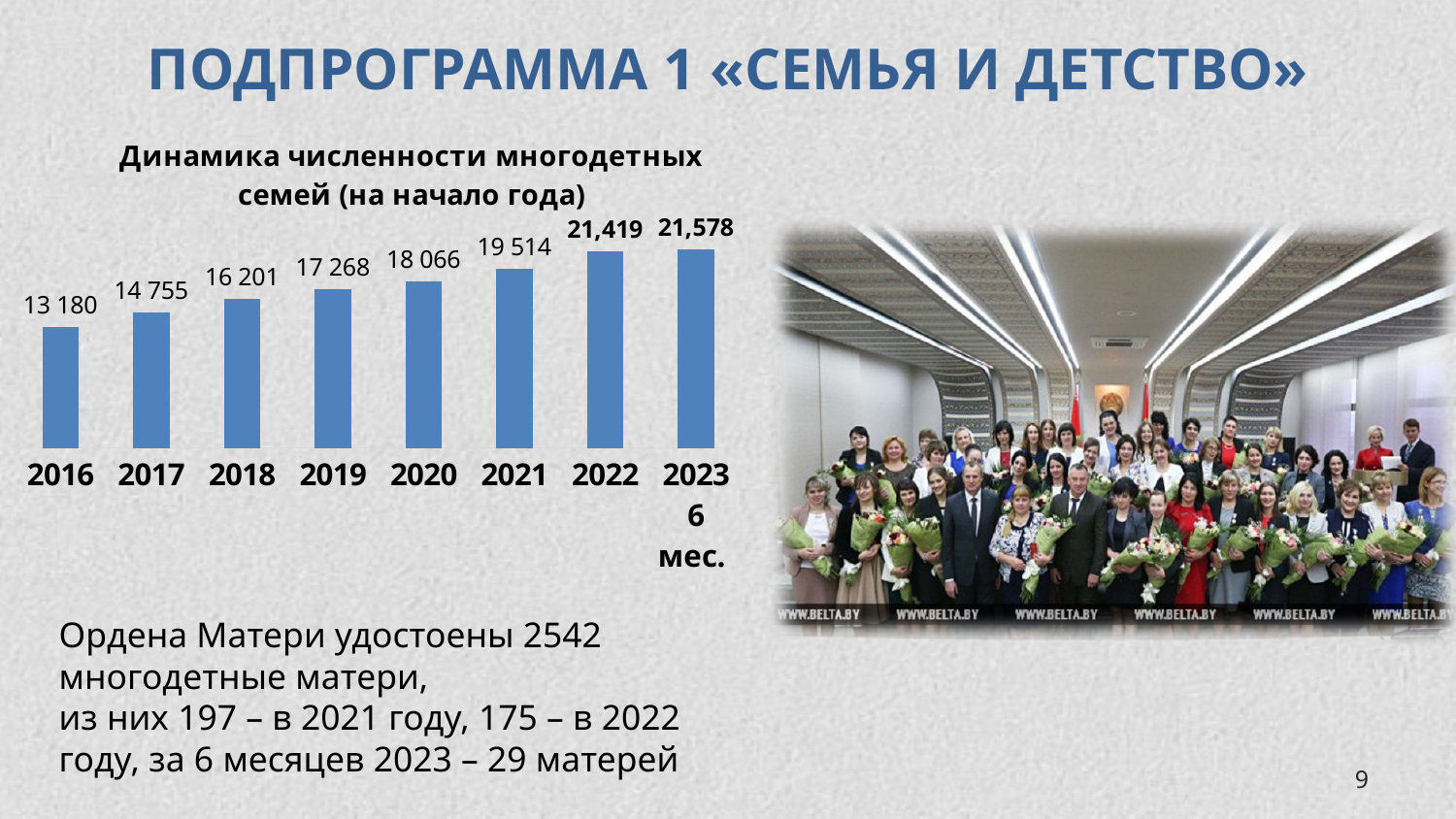
What is the value shown for 2022 in the chart? 21,419 What is the value for 2020 in the chart? 18 066 Which is larger, the value for 2019 or the value for 2018? 2019 Do the values rise or fall from 2016 to 2023 along the x axis? Rise What is the difference between the values for 2022 and 2021? 1905 Which category has the highest value in the chart? 2023 (6 мес.) What kind of chart is shown on the slide? Bar chart What is the difference between the values for 2017 and 2016? 1575 Which year has the lowest value in the chart? 2016 What is the value shown for 2023 (6 мес.) in the chart? 21,578 What is the value for 2016 in the chart 'Динамика численности многодетных семей (на начало года)'? 13 180 How many categories (bars) are shown in the chart? 8